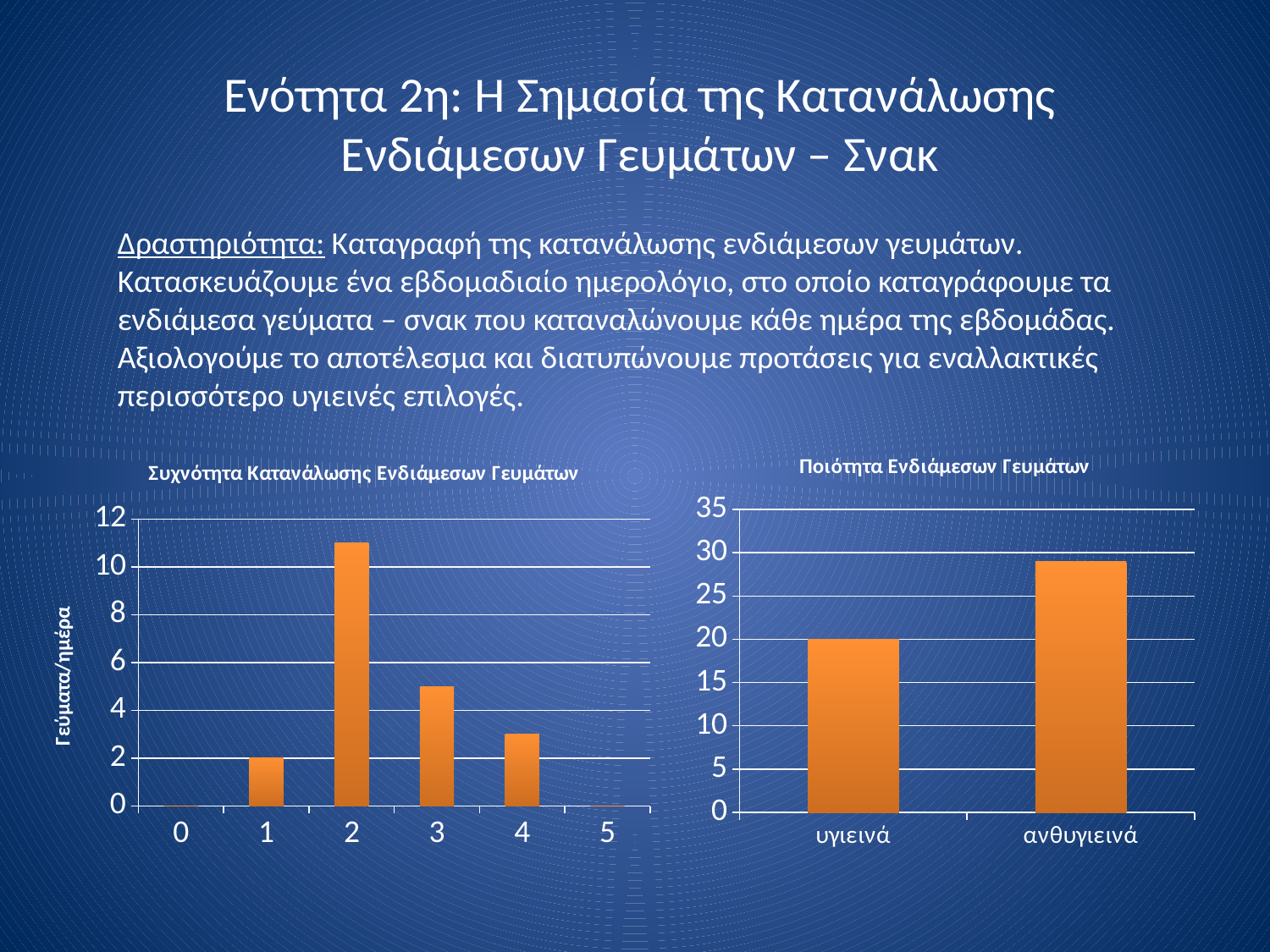
In the 'Συχνότητα Κατανάλωσης Ενδιάμεσων Γευμάτων' chart, how many categories are shown on the x axis? 6 In the 'Συχνότητα Κατανάλωσης Ενδιάμεσων Γευμάτων' chart, which has the larger value, category 3 or category 4? 3 In the 'Συχνότητα Κατανάλωσης Ενδιάμεσων Γευμάτων' chart, what is the value for category 1? 2 In the 'Συχνότητα Κατανάλωσης Ενδιάμεσων Γευμάτων' chart, is the value for category 3 greater or less than 6? less In the 'Συχνότητα Κατανάλωσης Ενδιάμεσων Γευμάτων' chart, what is the label of the y axis? Γεύματα/ημέρα In the 'Ποιότητα Ενδιάμεσων Γευμάτων' chart, which category has the highest value? ανθυγιεινά In the 'Ποιότητα Ενδιάμεσων Γευμάτων' chart, how many categories are shown? 2 In the 'Συχνότητα Κατανάλωσης Ενδιάμεσων Γευμάτων' chart, is the value for category 2 greater or less than 10? greater In the 'Συχνότητα Κατανάλωσης Ενδιάμεσων Γευμάτων' chart, which category has the highest bar? 2 In the 'Ποιότητα Ενδιάμεσων Γευμάτων' chart, is the value for ανθυγιεινά greater or less than 25? greater In the 'Ποιότητα Ενδιάμεσων Γευμάτων' chart, what is the value for υγιεινά? 20 What kind of chart is the 'Συχνότητα Κατανάλωσης Ενδιάμεσων Γευμάτων' chart on the left? bar chart